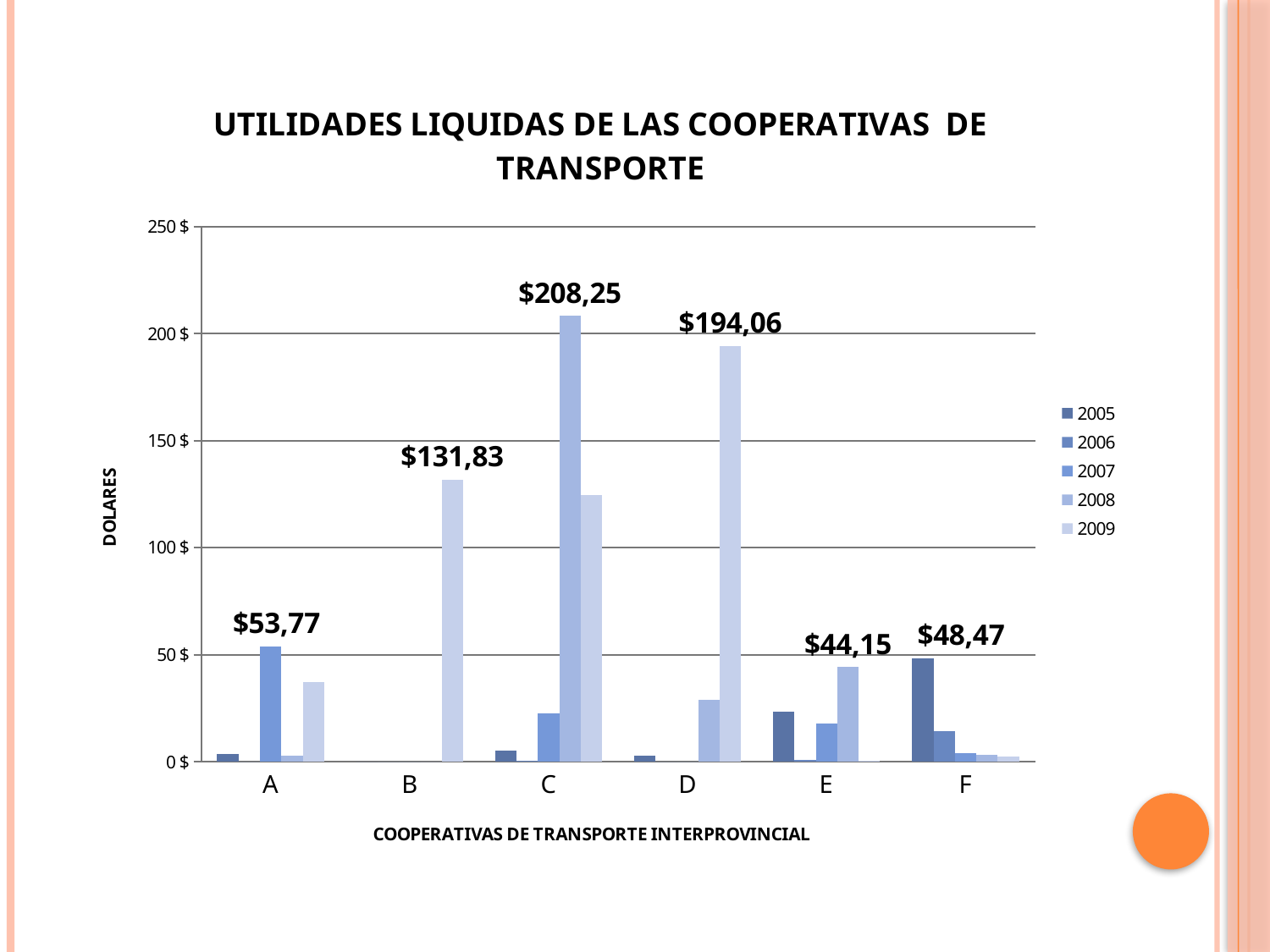
Which is larger: the labeled value for cooperativa A ($53,77) or the labeled value for cooperativa F ($48,47)? A ($53,77) What is the difference between the labeled value for C ($208,25) and the labeled value for D ($194,06)? $14,19 What is the title of the vertical axis? DOLARES Which cooperativa has the tallest bar in the chart? C What is the labeled value for cooperativa B in 2009? $131,83 Is the value for cooperativa A in 2009 greater or less than 50 $? less How many series does the legend list? 5 What kind of chart is shown on the slide? bar chart Is the value for cooperativa C in 2009 greater or less than 100 $? greater What is the labeled value for cooperativa E in 2008? $44,15 What is the labeled value for cooperativa C in 2008? $208,25 How many cooperativas (categories) are shown on the x axis? 6